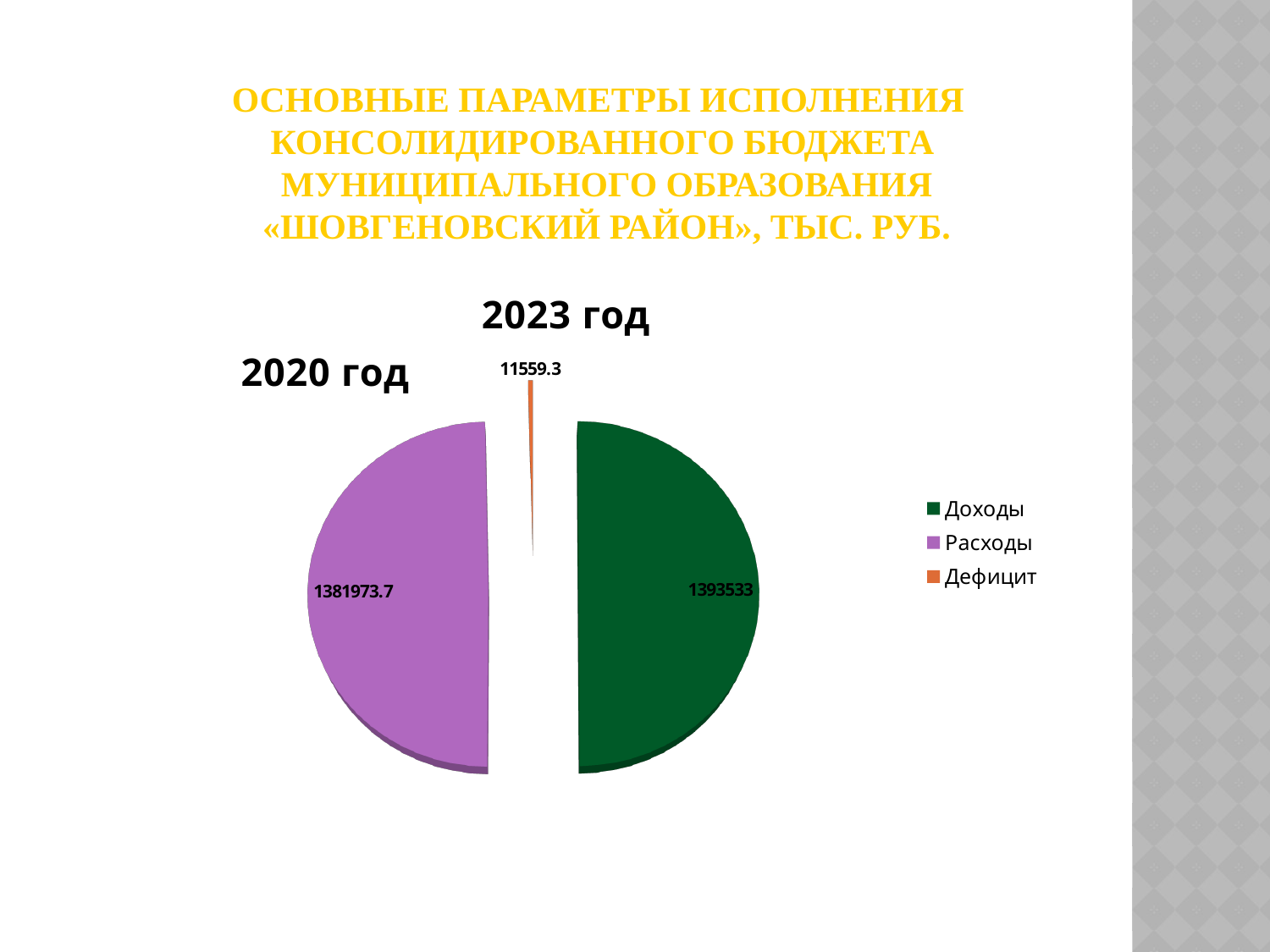
What type of chart is shown on the slide? Pie chart What share of the pie chart does the Доходы slice represent? 50% What colour is the Доходы slice in the pie chart? Green What is the value of the Расходы slice in the pie chart? 1381973.7 How many entries does the legend of the pie chart list? 3 How many slices does the pie chart have? 3 What is the value of the Дефицит slice in the pie chart? 11559.3 What is the value of the Доходы slice in the pie chart? 1393533 Which is larger in the pie chart, Доходы or Расходы? Доходы Which category has the smallest slice in the pie chart? Дефицит What is the difference between the Доходы and Расходы values in the pie chart? 11559.3 Which category has the largest slice in the pie chart? Доходы